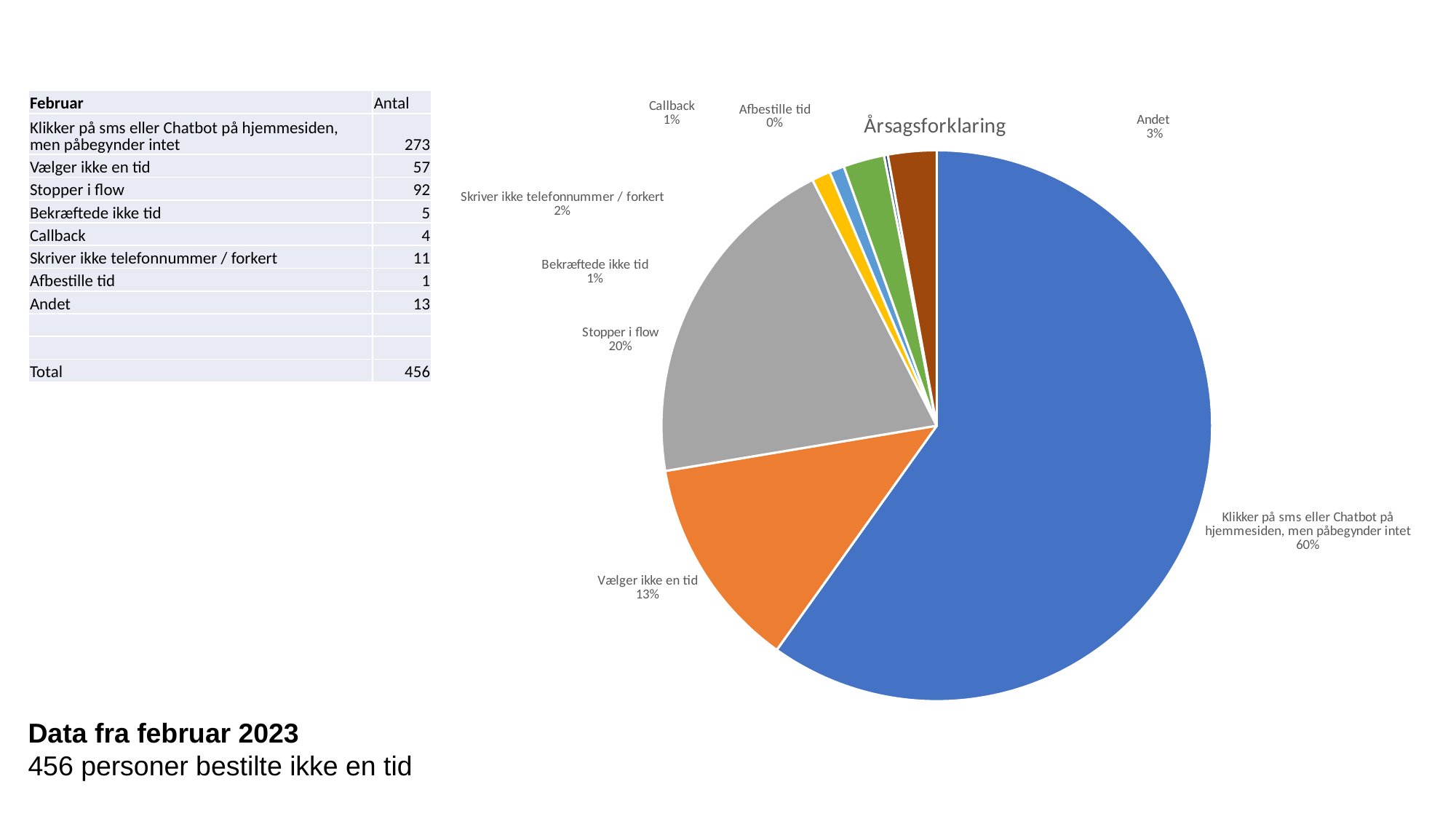
How many slices does the pie chart have? 8 What kind of chart is shown on the slide? Pie chart What share of the pie does "Vælger ikke en tid" represent? 13% What is the difference in percentage points between "Stopper i flow" and "Vælger ikke en tid"? 7% Which is larger, the share for "Stopper i flow" or the share for "Vælger ikke en tid"? Stopper i flow What share of the pie does "Stopper i flow" represent? 20% What percentage is shown for "Klikker på sms eller Chatbot på hjemmesiden, men påbegynder intet"? 60% What percentage is shown for "Skriver ikke telefonnummer / forkert"? 2% What percentage is shown for "Andet"? 3% Which category has the largest slice of the pie? Klikker på sms eller Chatbot på hjemmesiden, men påbegynder intet Which category has the smallest slice of the pie? Afbestille tid What is the title of the pie chart? Årsagsforklaring